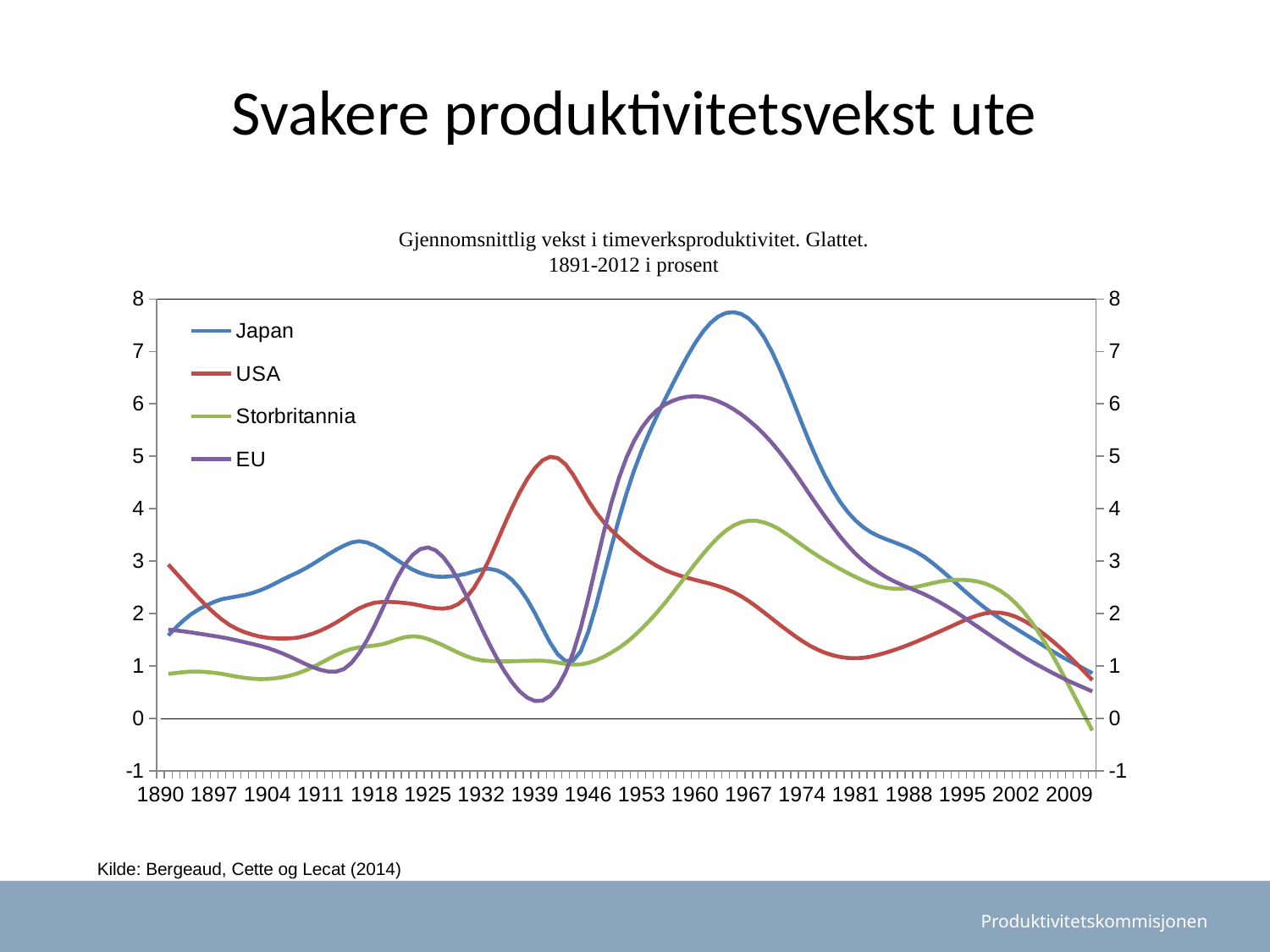
Which series reaches the highest value anywhere on the chart? Japan What is the title of the chart? Gjennomsnittlig vekst i timeverksproduktivitet. Glattet. 1891-2012 i prosent Is the peak value of the USA line around 1940 greater or less than 4? greater Is the peak value of the Japan line (around 1965) greater or less than 7? greater Around 1967, which series has the larger value, Japan or USA? Japan Is the value of the Storbritannia line at the right end of the chart (2012) greater or less than 0? less How many series does the chart's legend list? 4 Which series are listed in the chart's legend? Japan, USA, Storbritannia, EU What kind of chart is shown on the slide? line chart Does the Japan line rise or fall from 1967 to 2012? fall